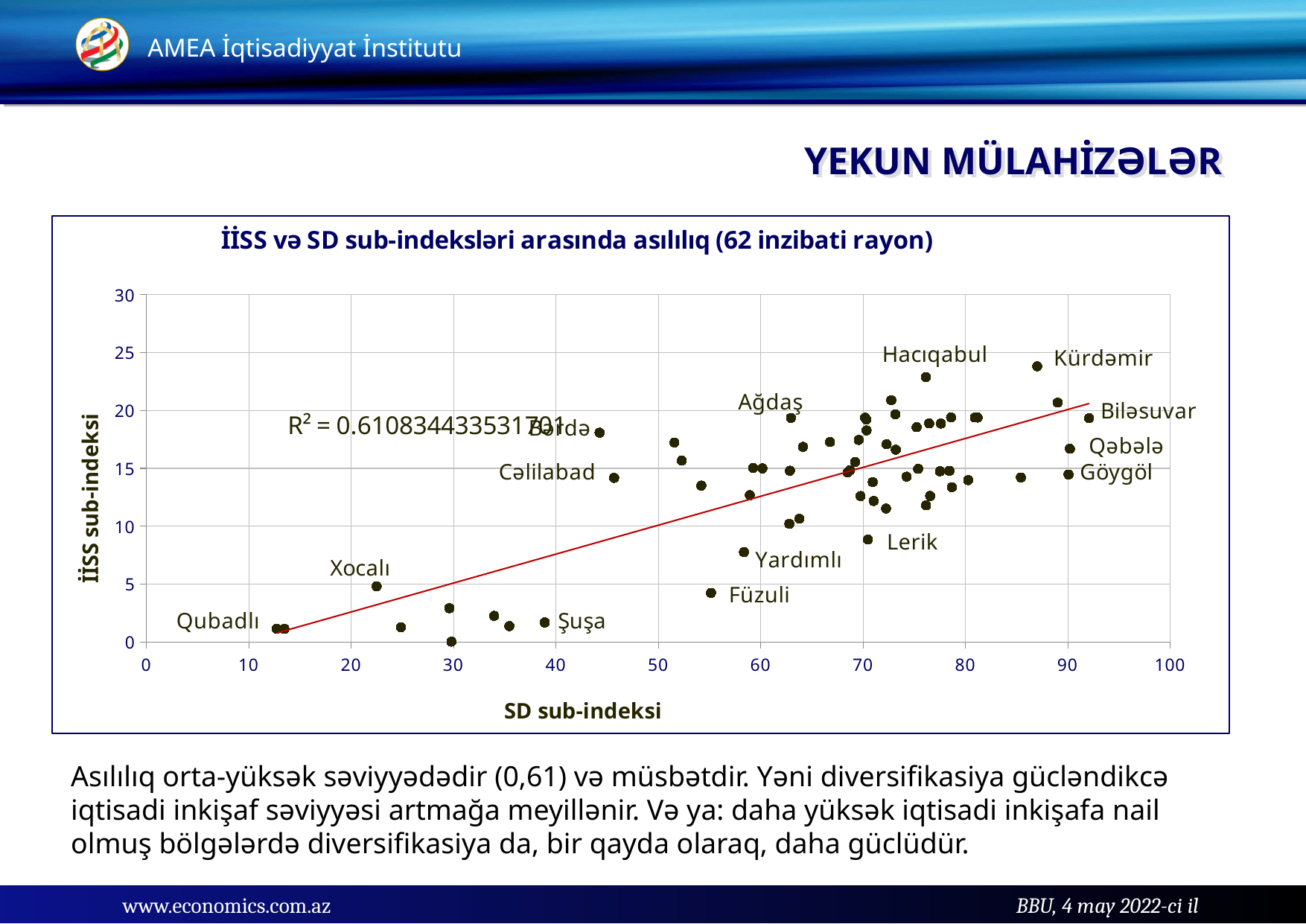
Is the SD sub-index value for Biləsuvar greater or less than 90? greater How many administrative districts (points) does the chart title say are plotted? 62 What is the title of the chart? İİSS və SD sub-indeksləri arasında asılılıq (62 inzibati rayon) Which has a higher İİSS sub-index value, Hacıqabul or Füzuli? Hacıqabul Which labelled district has the highest İİSS sub-index value? Kürdəmir What kind of chart is shown on the slide? Scatter chart What is the label of the horizontal axis? SD sub-indeksi Does the trend line rise or fall as the SD sub-index increases? Rises Which labelled district has the lowest İİSS sub-index value? Qubadlı Is the İİSS sub-index value for Kürdəmir greater or less than 20? greater Is the İİSS sub-index value for Qubadlı greater or less than 5? less